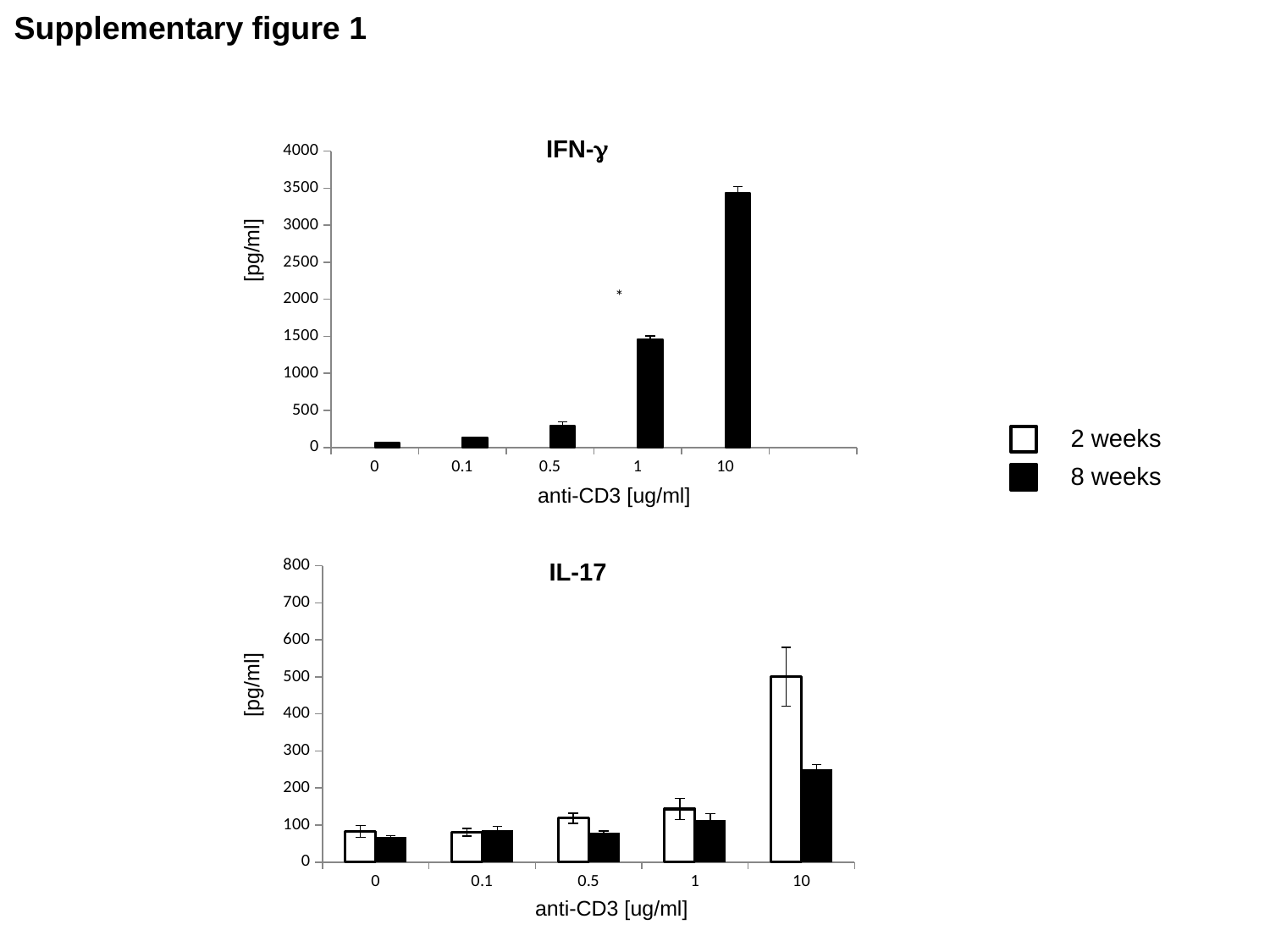
In the IFN-γ chart, at which anti-CD3 concentration is the 8 weeks value highest? 10 In the IL-17 chart, at which anti-CD3 concentration is the 2 weeks value highest? 10 In the IFN-γ chart, at which anti-CD3 concentration is the 8 weeks value lowest? 0 In the IL-17 chart, at 10 ug/ml anti-CD3, which is larger: the 2 weeks value or the 8 weeks value? 2 weeks How many series does the legend list? 2 How many anti-CD3 concentrations are shown on the x axis of the IL-17 chart? 5 In the IFN-γ chart, is the 8 weeks value at 0.5 ug/ml anti-CD3 greater or less than 500? less What kind of chart is the IFN-γ chart? bar chart In the IFN-γ chart, is the 8 weeks value at 10 ug/ml anti-CD3 greater or less than 3000? greater In the IL-17 chart, is the 8 weeks value at 10 ug/ml anti-CD3 greater or less than 200? greater What is the y-axis unit label on the IL-17 chart? [pg/ml] In the IFN-γ chart, do the 8 weeks values rise or fall as the anti-CD3 concentration increases? rise